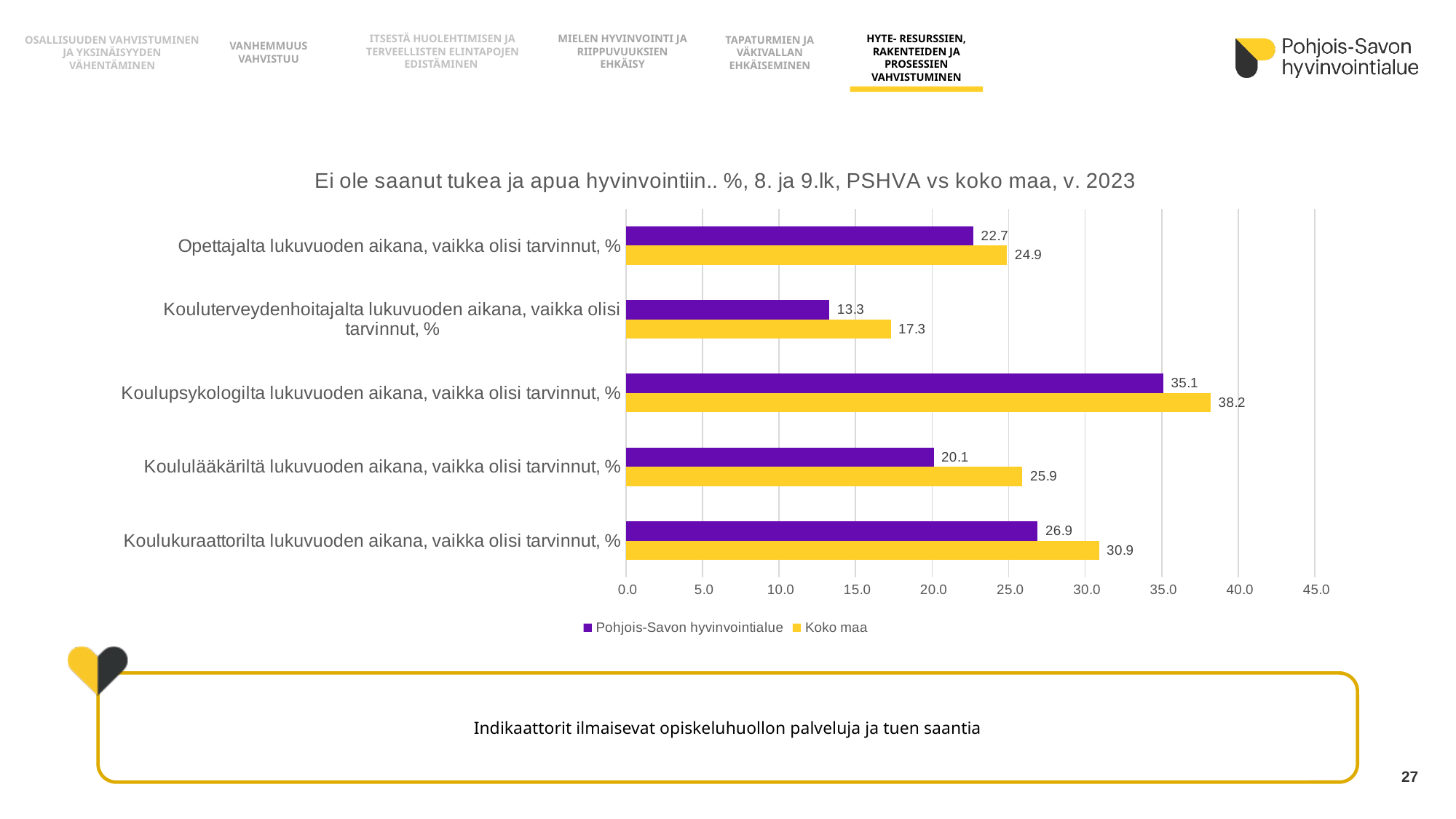
What is the value for Pohjois-Savon hyvinvointialue for 'Koulupsykologilta lukuvuoden aikana, vaikka olisi tarvinnut, %'? 35.1 Is the Pohjois-Savon hyvinvointialue value for 'Koulukuraattorilta lukuvuoden aikana, vaikka olisi tarvinnut, %' greater or less than 25.0? greater Which category has the lowest value for Pohjois-Savon hyvinvointialue? Kouluterveydenhoitajalta lukuvuoden aikana, vaikka olisi tarvinnut, % Which category has the highest value for Koko maa? Koulupsykologilta lukuvuoden aikana, vaikka olisi tarvinnut, % How many categories are shown on the chart? 5 Which colour represents Koko maa in the chart? Yellow What is the value for Koko maa for 'Kouluterveydenhoitajalta lukuvuoden aikana, vaikka olisi tarvinnut, %'? 17.3 What is the value for Koko maa for 'Koulukuraattorilta lukuvuoden aikana, vaikka olisi tarvinnut, %'? 30.9 What kind of chart is shown on the slide? Bar chart For 'Opettajalta lukuvuoden aikana, vaikka olisi tarvinnut, %', which series has the larger value, Pohjois-Savon hyvinvointialue or Koko maa? Koko maa What is the difference between Koko maa and Pohjois-Savon hyvinvointialue for 'Koululääkäriltä lukuvuoden aikana, vaikka olisi tarvinnut, %'? 5.8 How many series does the legend list? 2